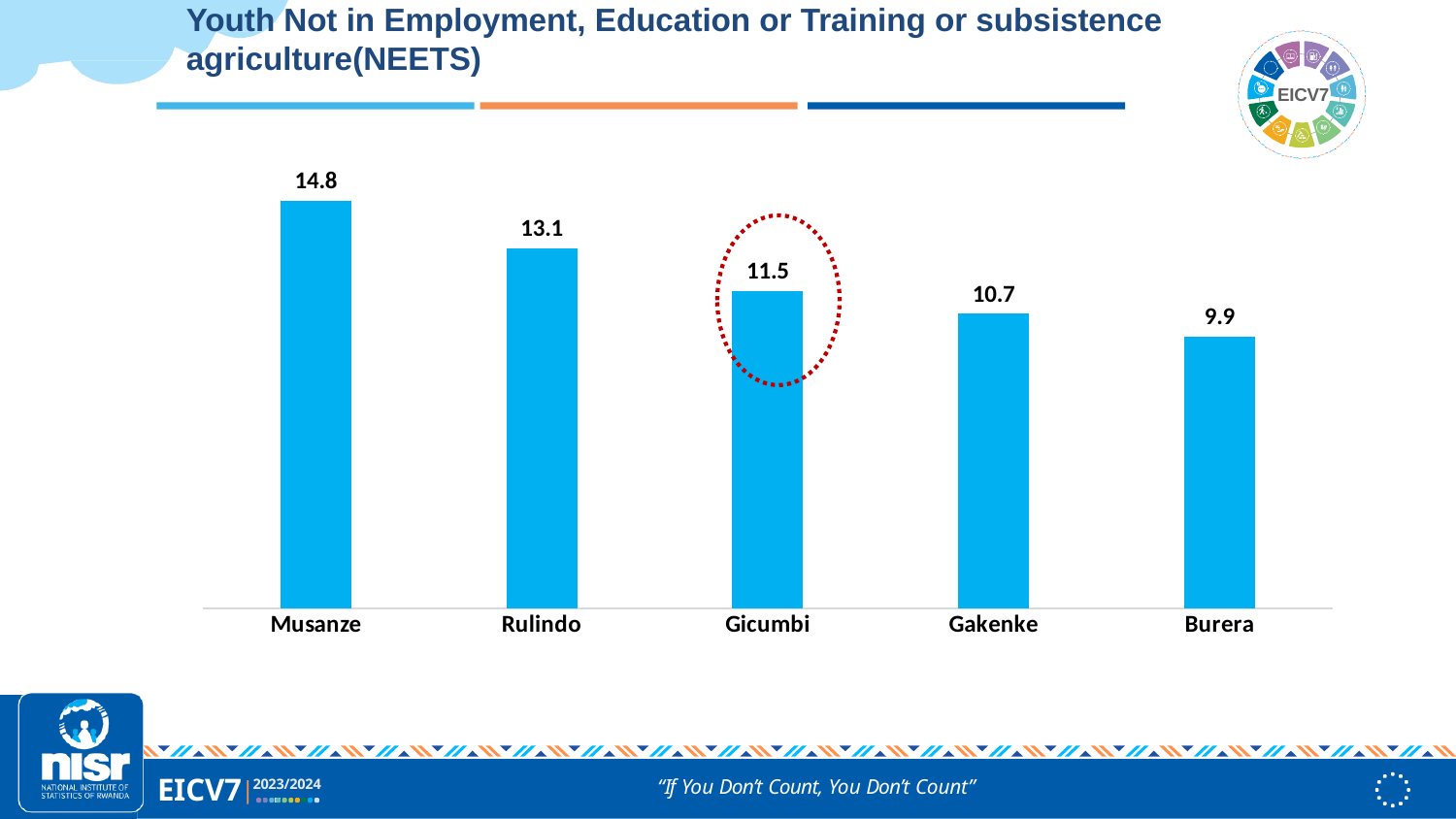
What is the difference between the values for Rulindo and Gicumbi? 1.6 What is the value for Burera? 9.9 What is the value for Gakenke? 10.7 What is the value for Musanze? 14.8 What is the value for Gicumbi? 11.5 Which district has the lowest value? Burera Which district's bar is circled with a red dotted outline? Gicumbi How many districts are shown in the chart? 5 Which district has the highest value? Musanze Which is larger, the value for Rulindo or the value for Gakenke? Rulindo What kind of chart is shown on the slide? Bar chart What is the difference between the values for Musanze and Burera? 4.9